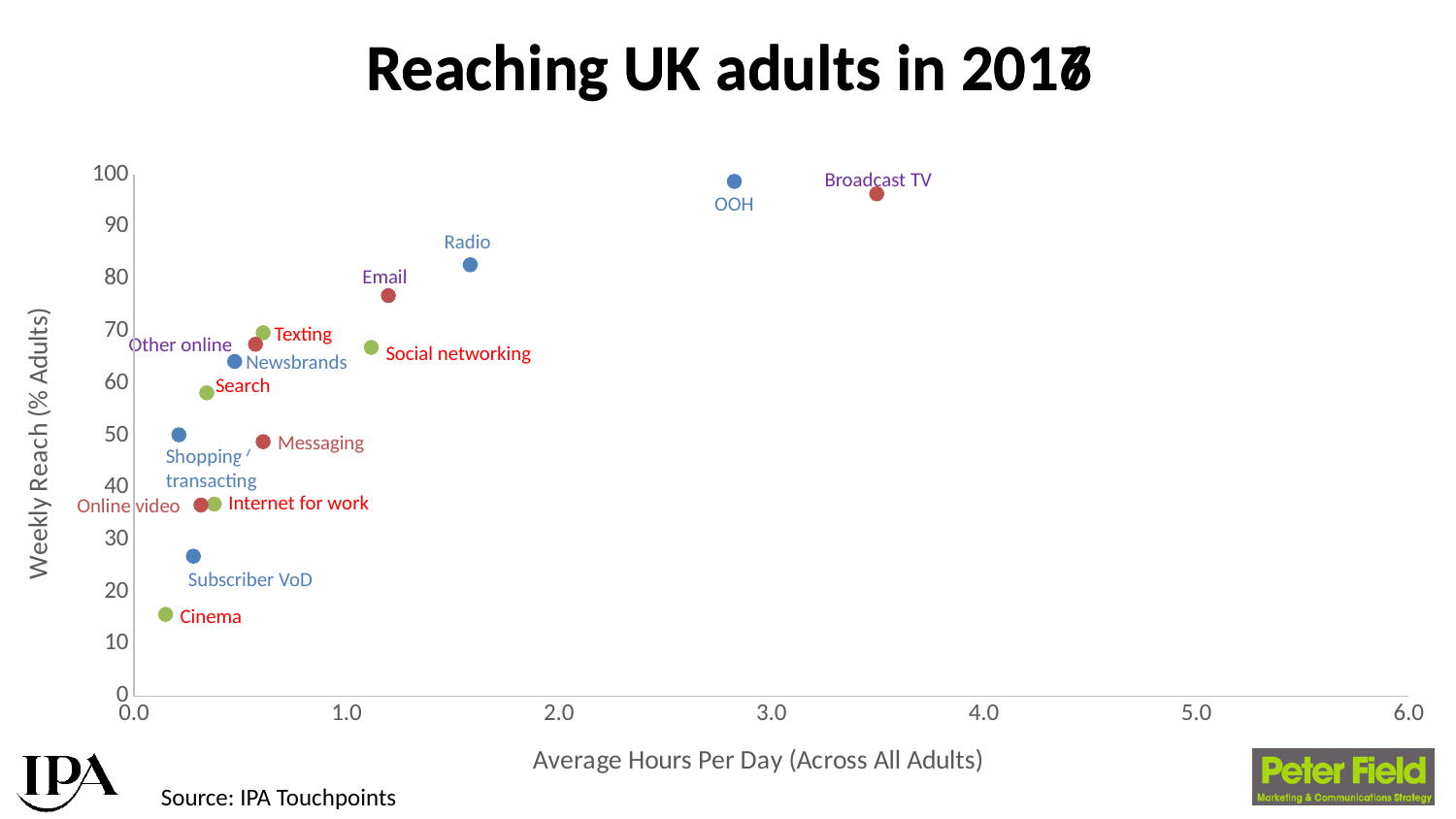
Which medium has the lowest weekly reach? Cinema Is the weekly reach for Subscriber VoD greater or less than 20? greater How many media points are plotted on the chart? 15 Which has the higher weekly reach, Radio or Email? Radio Which has more average hours per day, Broadcast TV or OOH? Broadcast TV Is the weekly reach for Email greater or less than 80? less What is the label of the vertical axis? Weekly Reach (% Adults) What is the label of the horizontal axis? Average Hours Per Day (Across All Adults) Is the average hours per day for Broadcast TV greater or less than 3.0? greater What kind of chart is shown on the slide? Scatter chart Which medium has the highest average hours per day? Broadcast TV